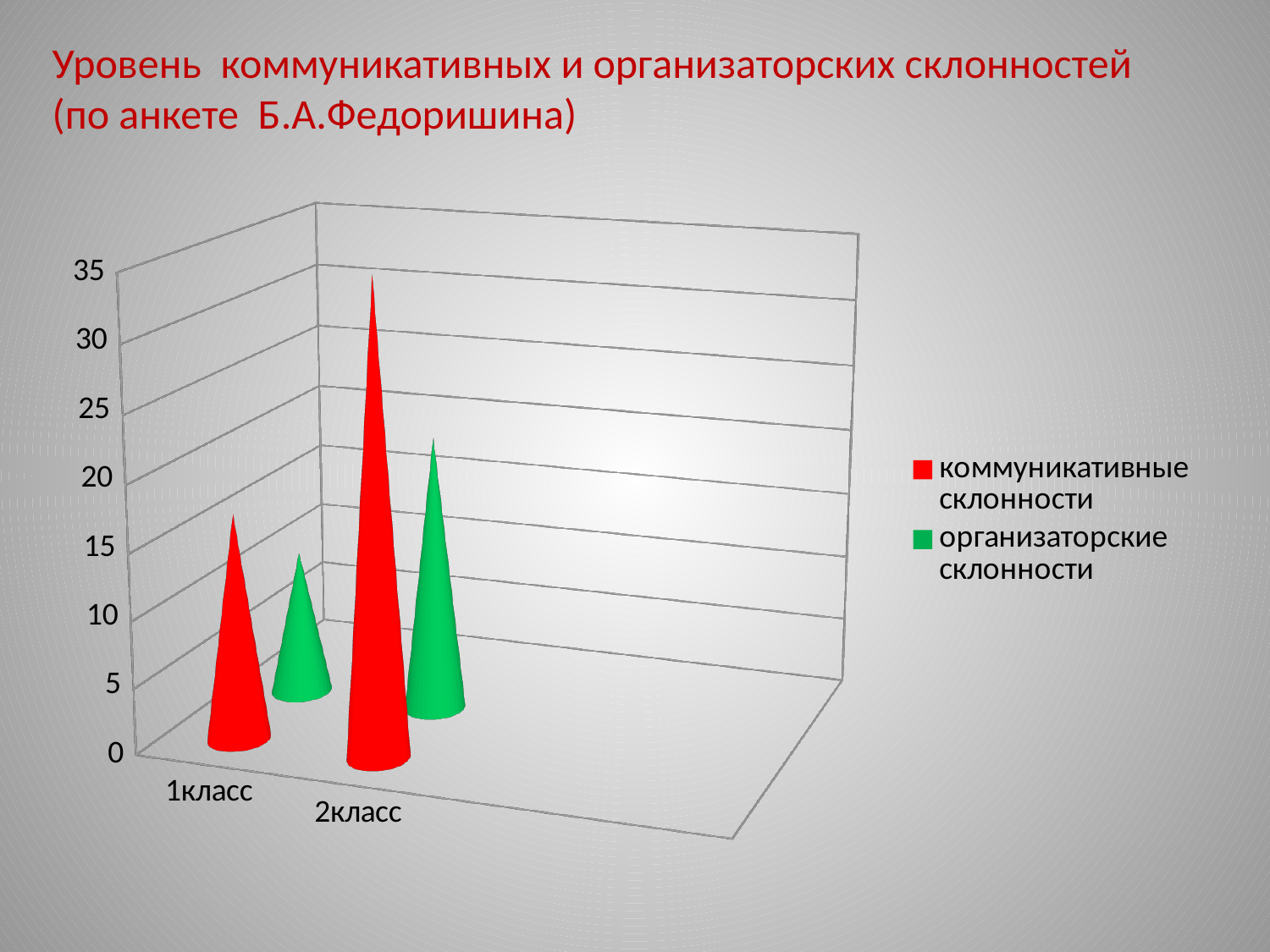
For 2класс, which is larger: коммуникативные склонности or организаторские склонности? коммуникативные склонности Which category has the lower value for организаторские склонности? 1класс What kind of chart is shown on the slide? bar chart Do the values for коммуникативные склонности rise or fall from 1класс to 2класс? rise For 1класс, which is larger: коммуникативные склонности or организаторские склонности? коммуникативные склонности Is the value for коммуникативные склонности in 2класс greater or less than 20? greater Which colour represents организаторские склонности in the legend? green How many series does the chart legend list? 2 How many categories are shown on the x axis of the chart? 2 Is the value for организаторские склонности in 1класс greater or less than 20? less What is the title of the slide containing the chart? Уровень коммуникативных и организаторских склонностей (по анкете Б.А.Федоришина) Which category has the higher value for коммуникативные склонности, 1класс or 2класс? 2класс